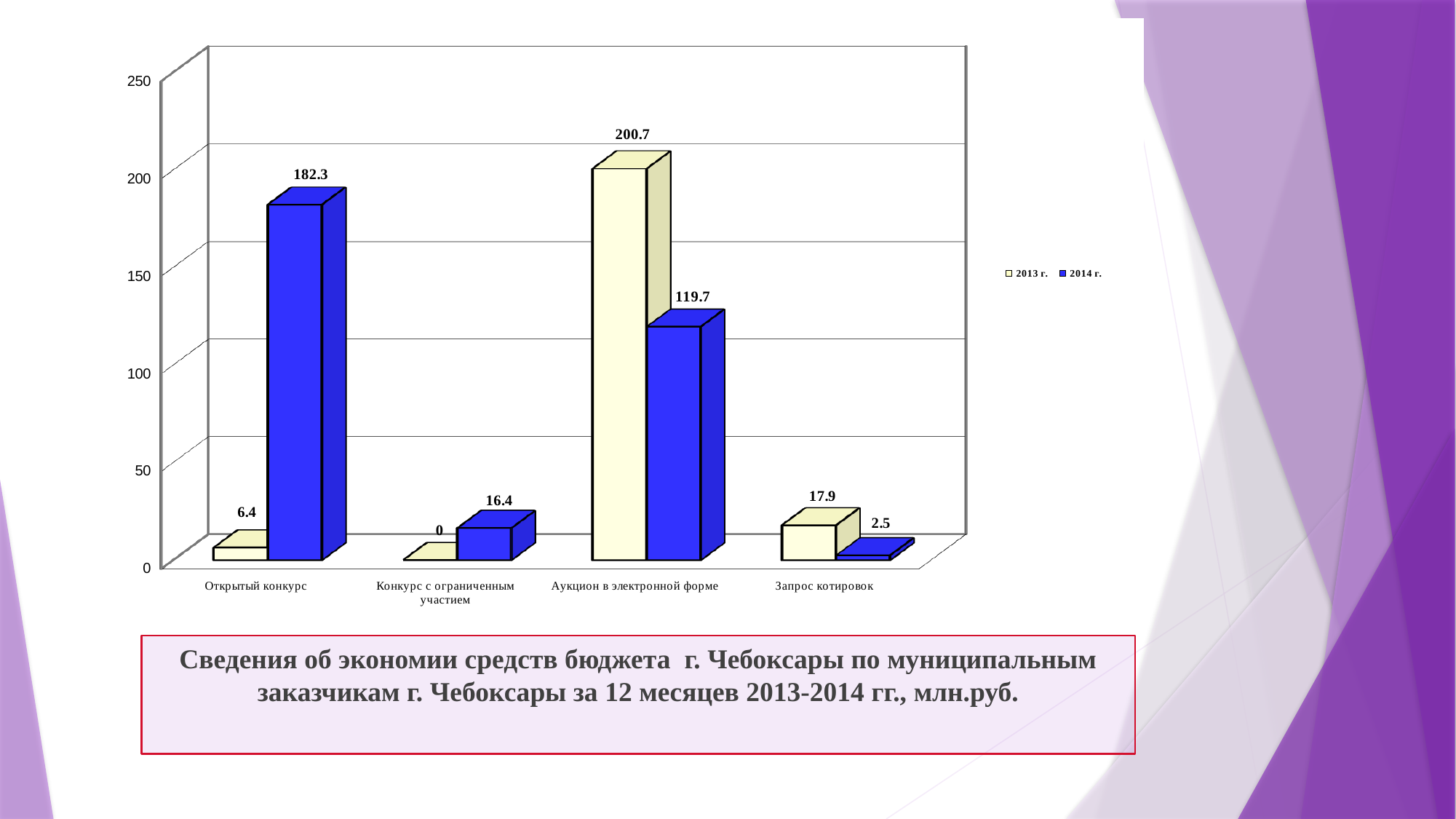
What is the value for 2013 г. for Открытый конкурс? 6.4 Which is larger for Конкурс с ограниченным участием: the 2013 г. value or the 2014 г. value? 2014 г. What is the value for 2014 г. for Открытый конкурс? 182.3 Which colour represents the 2014 г. series? Blue What is the value for 2013 г. for Аукцион в электронной форме? 200.7 What kind of chart is shown on the slide? Bar chart What is the value for 2014 г. for Запрос котировок? 2.5 Which category has the highest value for 2013 г.? Аукцион в электронной форме How many series does the legend list? 2 Which category has the lowest value for 2014 г.? Запрос котировок What is the difference between the 2013 г. and 2014 г. values for Аукцион в электронной форме? 81 How many categories are shown on the x axis? 4